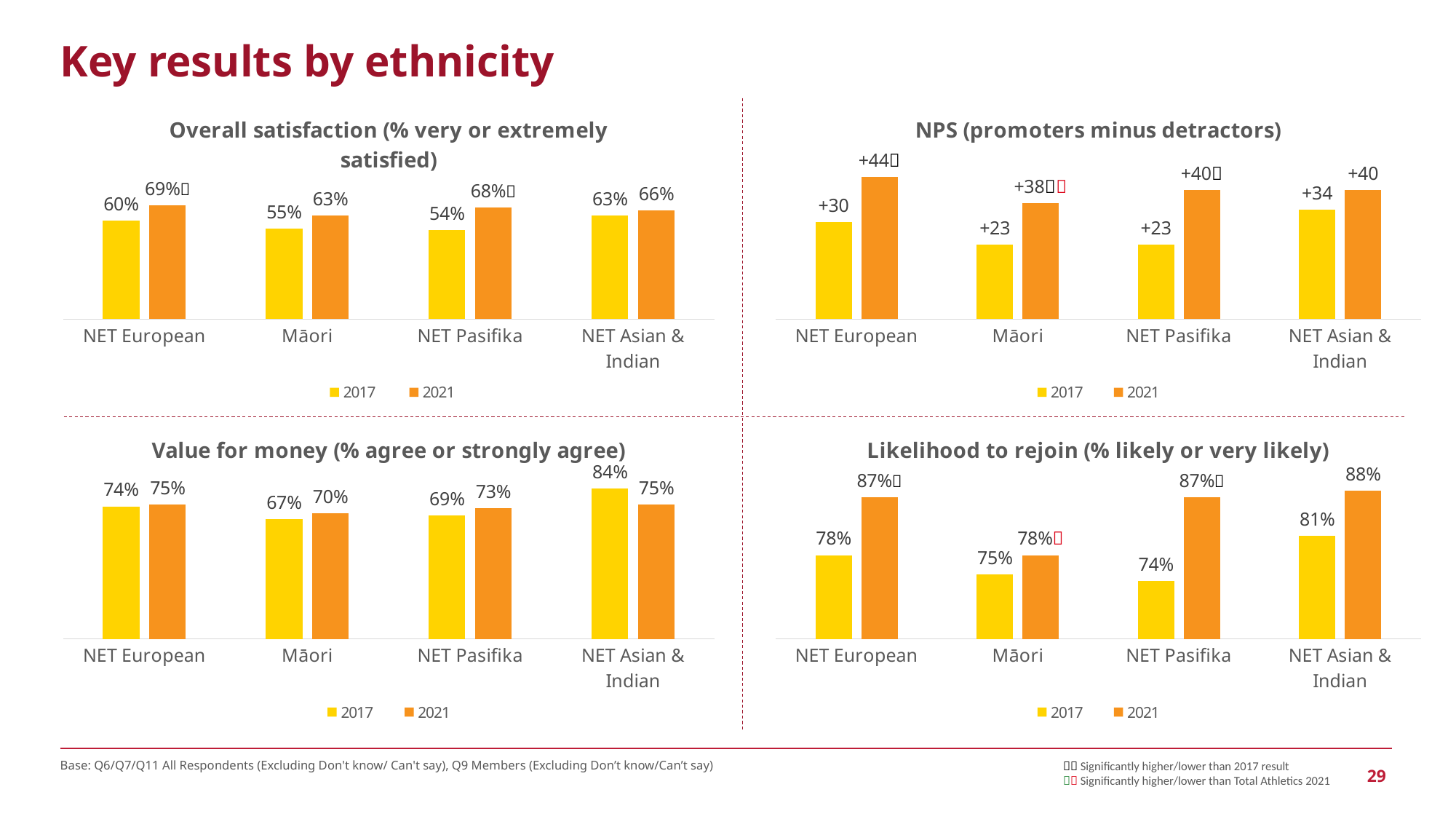
In the 'Value for money' chart, is the 2017 or 2021 value larger for NET Asian & Indian? 2017 In the 'Value for money' chart, what is the 2017 value for NET Asian & Indian? 84% In the 'NPS (promoters minus detractors)' chart, which ethnicity has the highest 2021 value? NET European In the 'Overall satisfaction' chart, what is the 2021 value for NET Pasifika? 68% In the 'Likelihood to rejoin' chart, what is the 2021 value for NET Asian & Indian? 88% How many ethnicity categories are shown in the 'Likelihood to rejoin' chart? 4 In the 'Value for money' chart, which ethnicity has the lowest 2017 value? Māori In the 'Overall satisfaction' chart, which ethnicity has the lowest 2017 value? NET Pasifika In the 'NPS (promoters minus detractors)' chart, what is the difference between the 2021 and 2017 values for Māori? 15 How many series does the legend of the 'Overall satisfaction' chart list? 2 In the 'NPS (promoters minus detractors)' chart, what is the 2017 value for NET Asian & Indian? +34 In the 'Likelihood to rejoin' chart, what is the difference between the 2021 and 2017 values for NET Pasifika? 13%